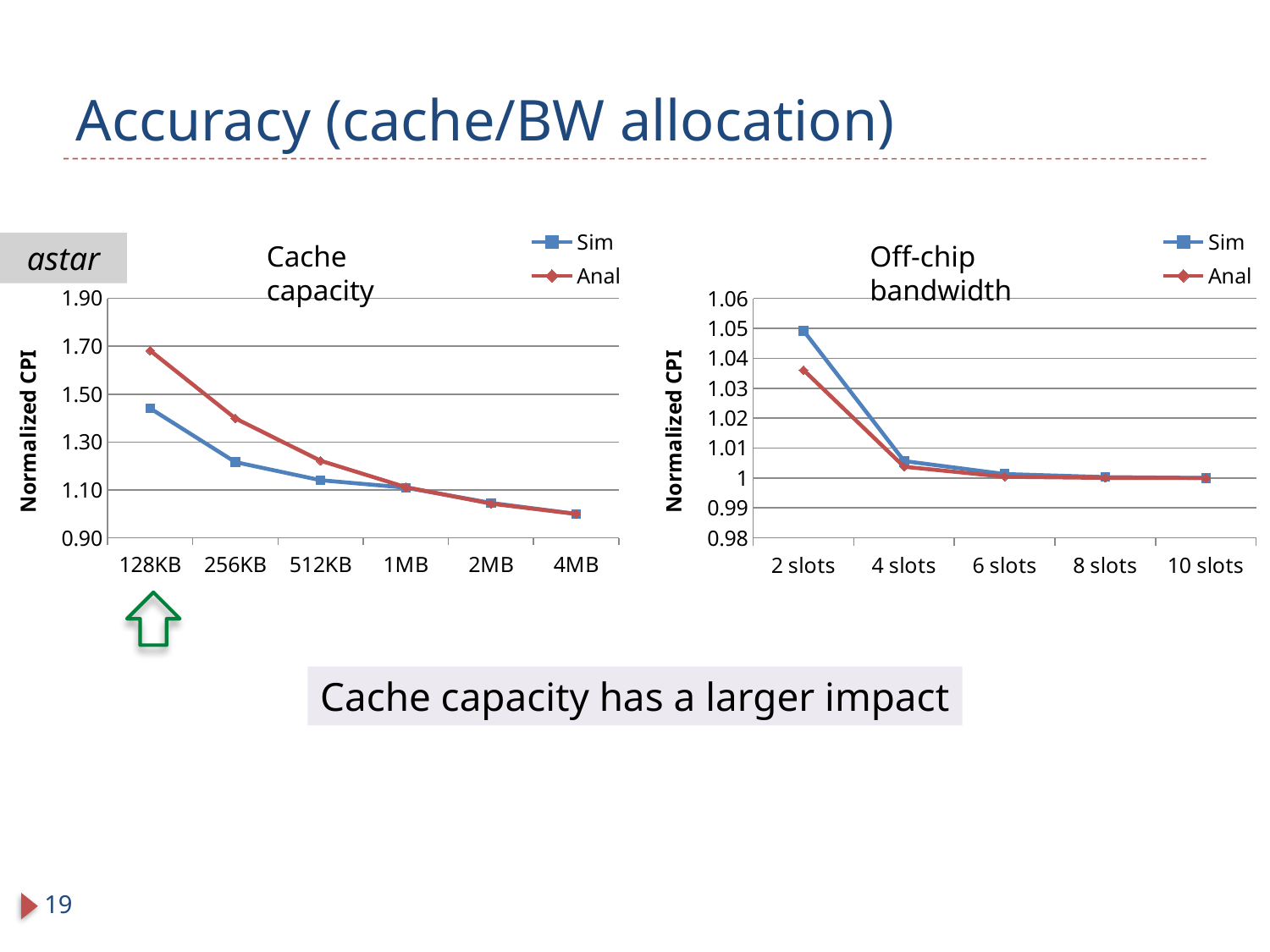
In the Cache capacity chart, is the Sim value at 256KB greater or less than 1.30? less What type of chart is the Cache capacity chart? line chart In the Off-chip bandwidth chart, do the Anal values rise or fall from 2 slots to 10 slots? fall What is the y-axis label of the Off-chip bandwidth chart? Normalized CPI How many series does the legend of the Off-chip bandwidth chart list? 2 In the Off-chip bandwidth chart, is the Sim value at 2 slots greater or less than 1.04? greater In the Cache capacity chart, is the Anal value at 128KB greater or less than 1.50? greater How many slot settings are shown on the x axis of the Off-chip bandwidth chart? 5 In the Cache capacity chart, at which cache size is the Anal series highest? 128KB In the Cache capacity chart, do the Sim values rise or fall as cache capacity increases from 128KB to 4MB? fall How many cache sizes are shown on the x axis of the Cache capacity chart? 6 In the Cache capacity chart, which series has the larger value at 128KB, Sim or Anal? Anal